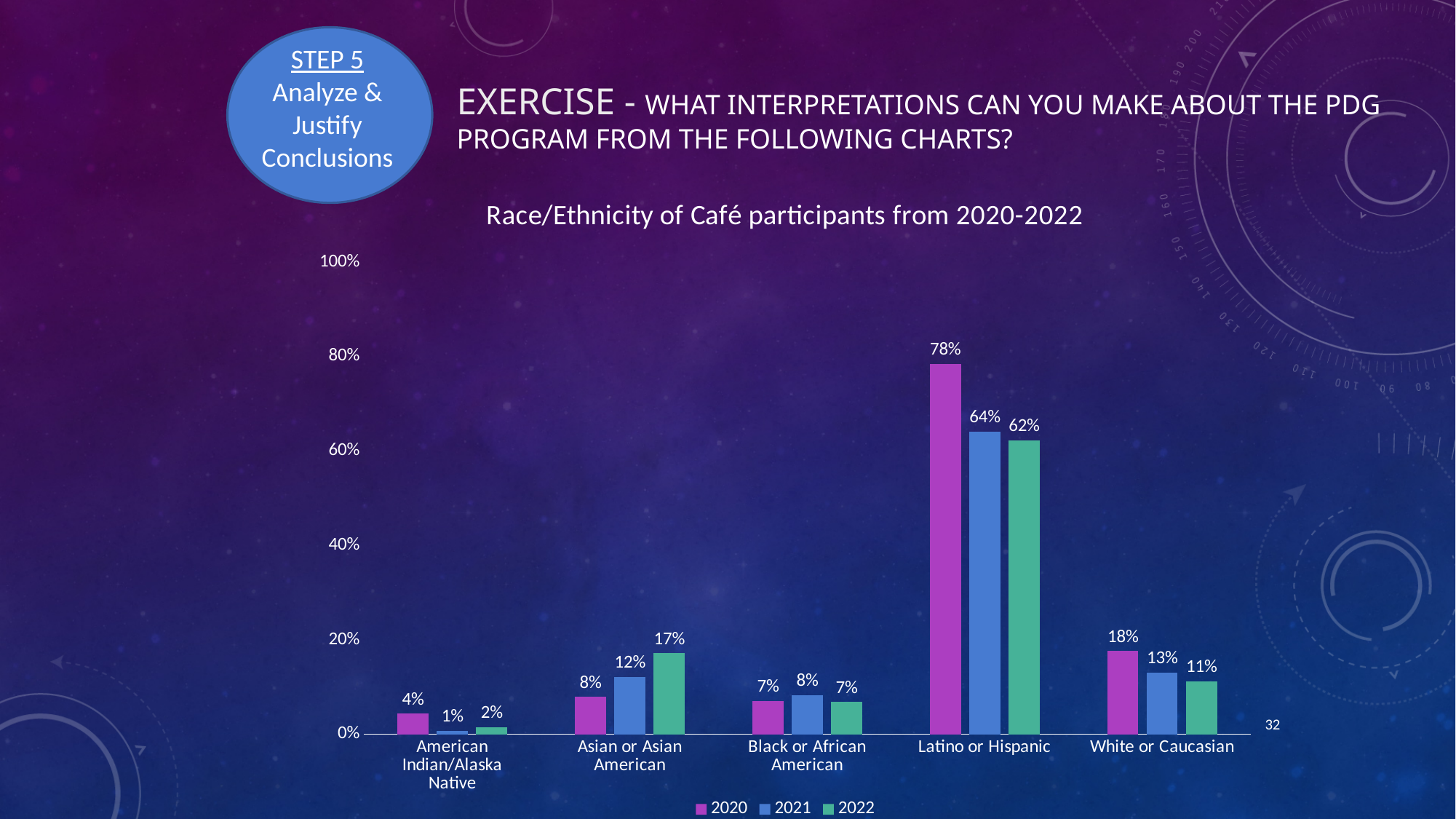
What type of chart is shown on the slide? Bar chart What is the title of the chart? Race/Ethnicity of Café participants from 2020-2022 How many race/ethnicity categories are shown on the x axis? 5 Which race/ethnicity category had the highest percentage of Café participants in 2022? Latino or Hispanic What was the percentage of White or Caucasian Café participants in 2022? 11% What was the percentage of Asian or Asian American Café participants in 2021? 12% Which race/ethnicity category had the lowest percentage of Café participants in 2021? American Indian/Alaska Native Did the share of Asian or Asian American participants rise or fall from 2020 to 2022? Rise Which was larger in 2022: the share of Asian or Asian American participants or the share of White or Caucasian participants? Asian or Asian American What was the percentage of Latino or Hispanic Café participants in 2020? 78% How many series does the legend list? 3 By how many percentage points did the Latino or Hispanic share fall from 2020 to 2022? 16